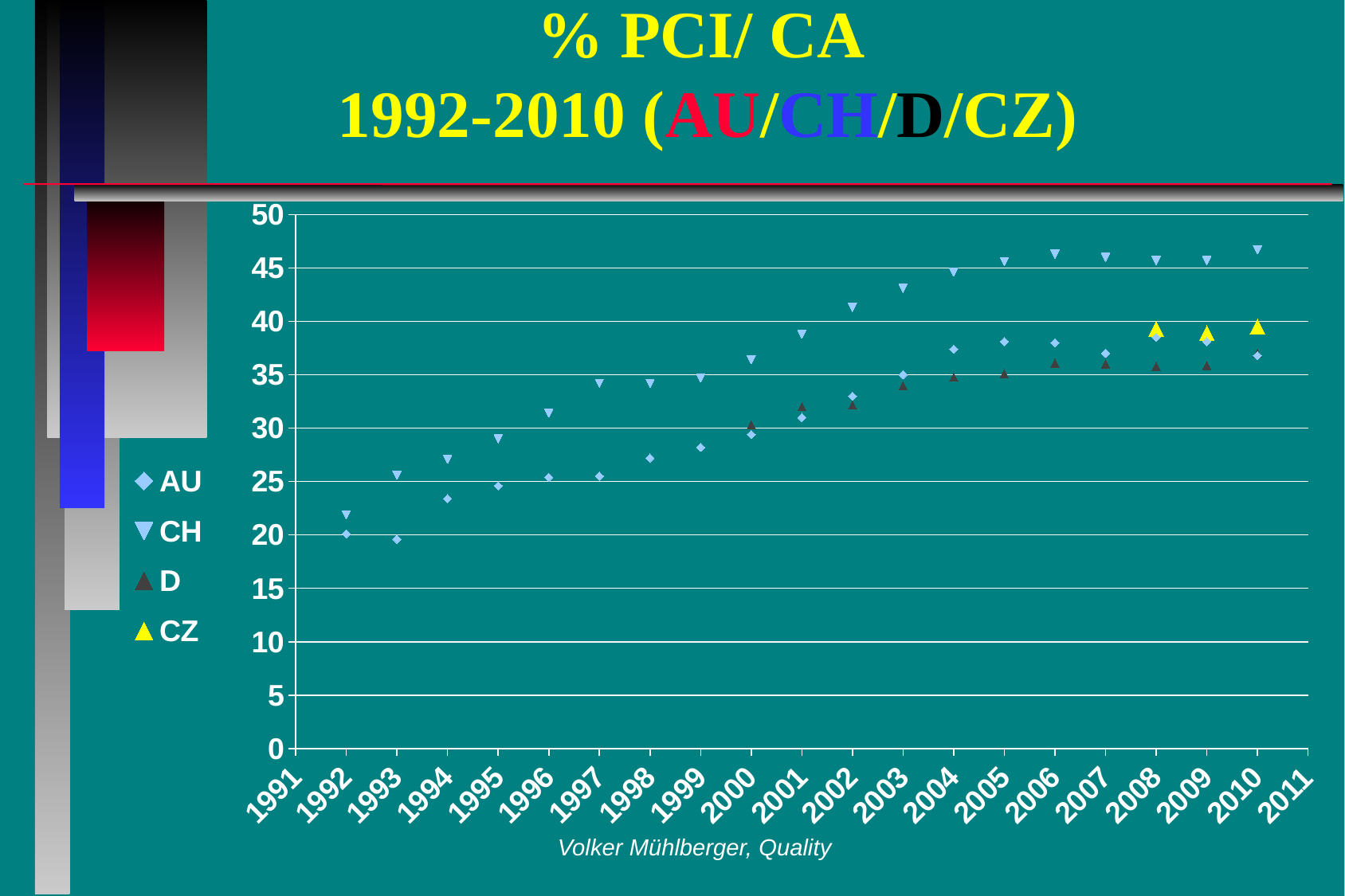
Which series has the highest value in 2010? CH Is the value for CH in 2003 greater or less than 45? less Is the value for CH in 2010 greater or less than 45? greater Is the value for AU in 1999 greater or less than 30? less How many series does the legend list? 4 What kind of chart is shown on the slide? scatter chart Which series has the lowest value in 2005? D For how many years are CZ values plotted? 3 What is the title of the chart? % PCI/ CA 1992-2010 (AU/CH/D/CZ) Does the CH series rise or fall from 1992 to 2010? rise Which is larger in 2010, the value for CH or the value for AU? CH